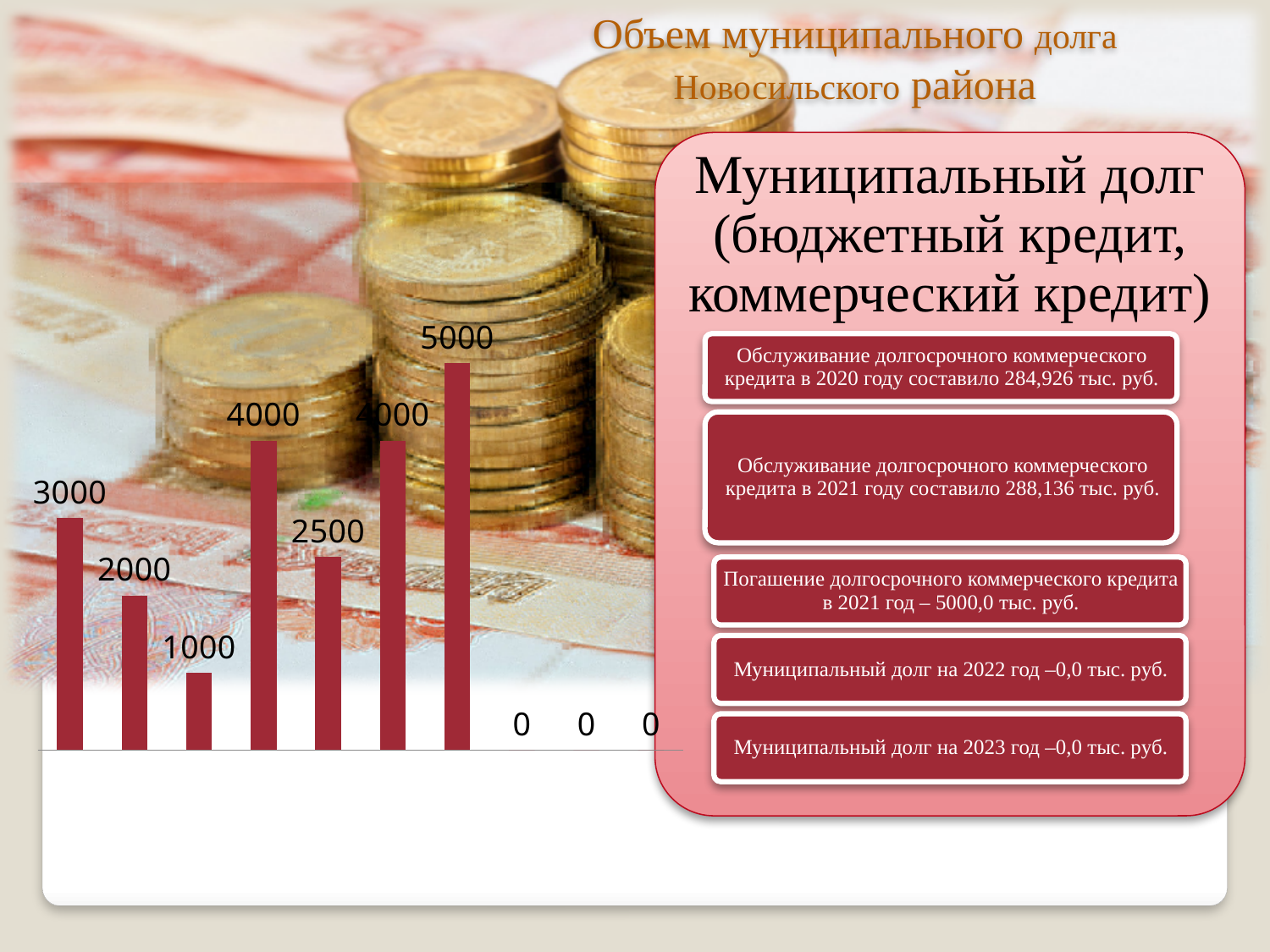
What is the highest value labelled on any bar in the chart? 5000 What is the value of the leftmost bar in the chart? 3000 How many bars in the chart have a non-zero value? 7 What is the smallest non-zero value labelled on a bar in the chart? 1000 What is the value of the second bar from the left in the chart? 2000 What colour are the bars in the chart? dark red What kind of chart is shown on the left side of the slide? bar chart Which is larger: the leftmost bar or the second bar from the left? the leftmost bar What is the value of the third bar from the left in the chart? 1000 What is the value of the fifth bar from the left in the chart? 2500 How many data labels in the chart show a value of 0? 3 What is the difference between the tallest bar (5000) and the fourth bar from the left (4000)? 1000